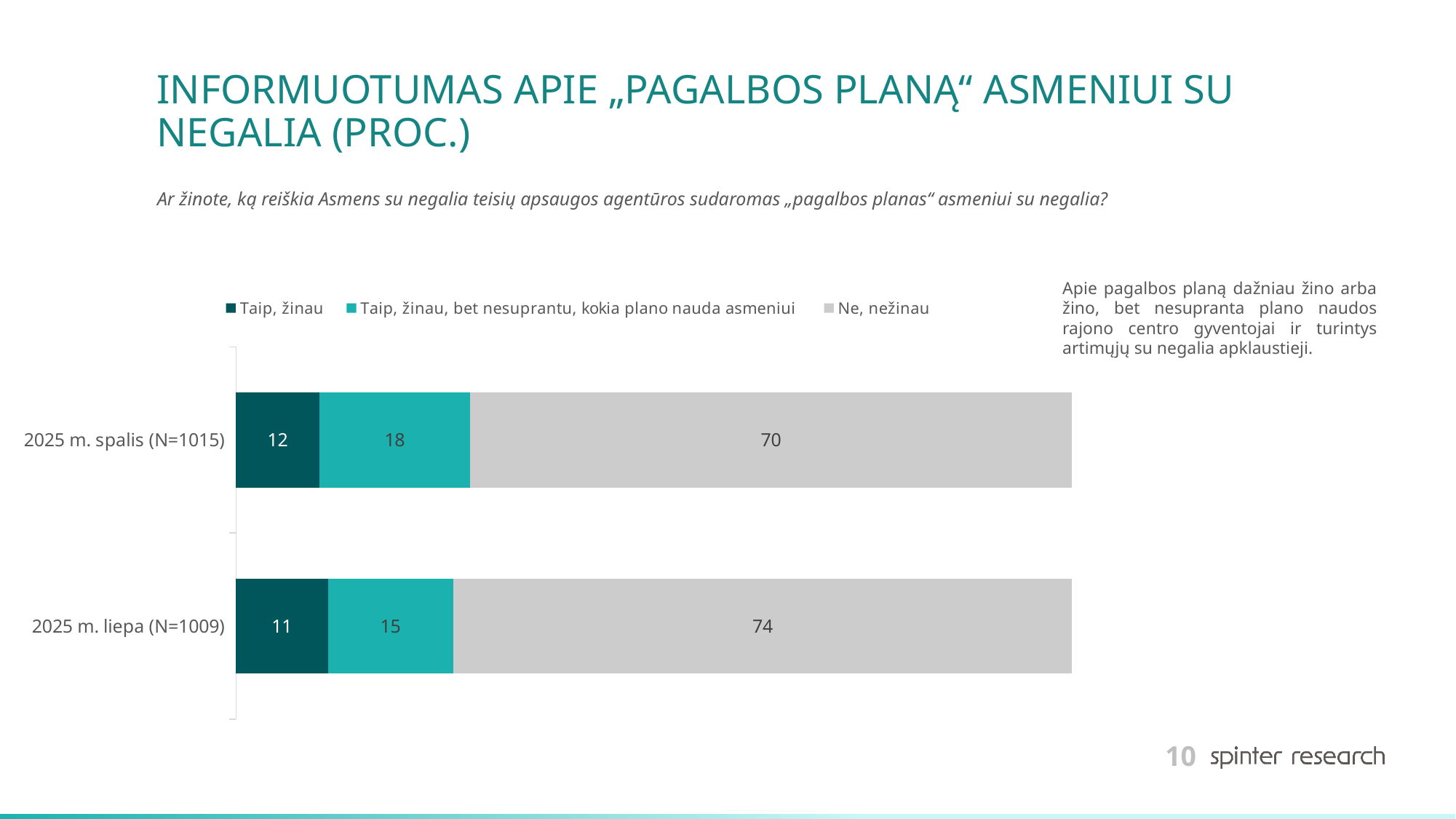
Which category has the highest value for "Ne, nežinau"? 2025 m. liepa (N=1009) Which category has the lowest value for "Taip, žinau, bet nesuprantu, kokia plano nauda asmeniui"? 2025 m. liepa (N=1009) How many categories are shown on the chart? 2 What is the value for "Ne, nežinau" in 2025 m. liepa (N=1009)? 74 What is the value for "Taip, žinau, bet nesuprantu, kokia plano nauda asmeniui" in 2025 m. spalis (N=1015)? 18 What is the difference between the "Ne, nežinau" values for 2025 m. liepa (N=1009) and 2025 m. spalis (N=1015)? 4 What is the value for "Ne, nežinau" in 2025 m. spalis (N=1015)? 70 What kind of chart is shown on the slide? Stacked bar chart What is the total of the stacked bar for 2025 m. spalis (N=1015)? 100 What is the value for "Taip, žinau" in 2025 m. liepa (N=1009)? 11 Which is larger: "Taip, žinau" in 2025 m. spalis (N=1015) or "Taip, žinau" in 2025 m. liepa (N=1009)? 2025 m. spalis (N=1015) How many series does the legend list? 3